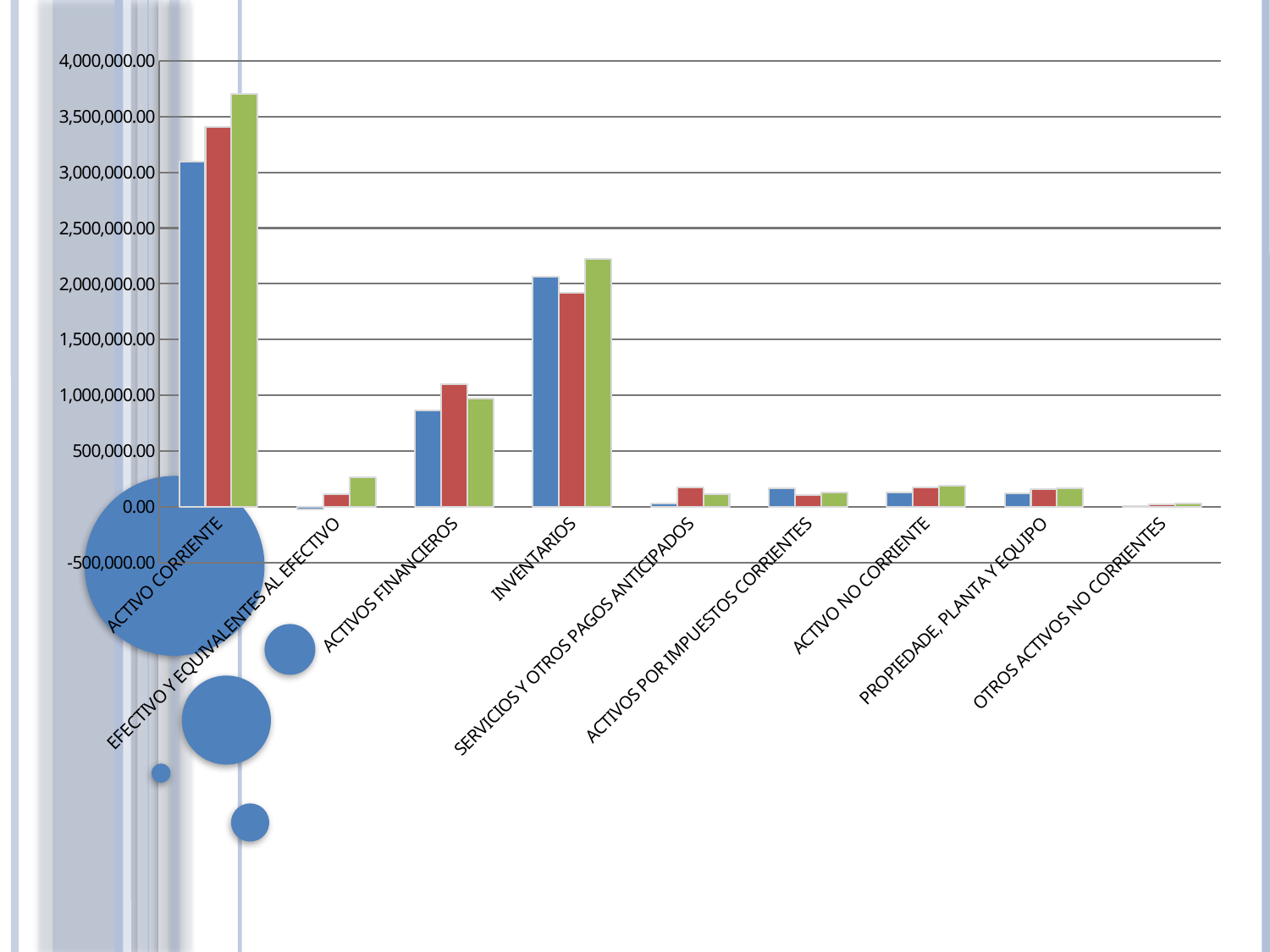
How many bars are plotted for each category in the chart? 3 Is the green bar for ACTIVO CORRIENTE greater or less than 3,500,000.00? greater Which category has the smallest bars in the chart? OTROS ACTIVOS NO CORRIENTES Is the blue bar for ACTIVOS FINANCIEROS greater or less than 1,000,000.00? less Which category has the tallest bars in the chart? ACTIVO CORRIENTE How many categories are shown on the x axis of the chart? 9 What is the highest value shown on the vertical axis of the chart? 4,000,000.00 What kind of chart is shown on the slide? bar chart Is the blue bar for ACTIVO CORRIENTE greater or less than 2,500,000.00? greater Which category has the larger green bar, ACTIVO CORRIENTE or INVENTARIOS? ACTIVO CORRIENTE